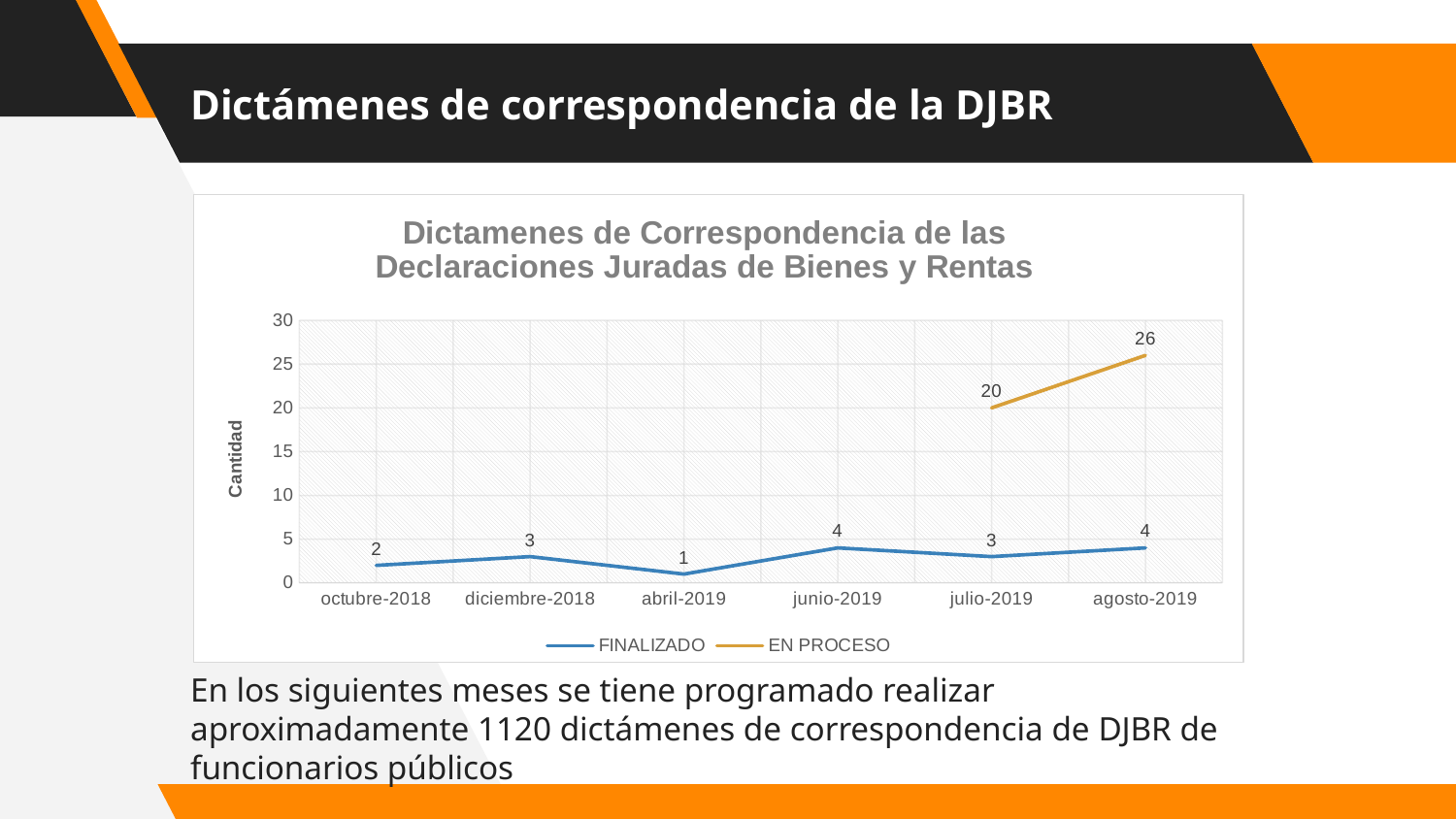
How many series does the legend list? 2 What is the EN PROCESO value for agosto-2019? 26 What is the FINALIZADO value for octubre-2018? 2 What is the label of the y axis? Cantidad Does the EN PROCESO series rise or fall from julio-2019 to agosto-2019? rise What is the FINALIZADO value for abril-2019? 1 What is the EN PROCESO value for julio-2019? 20 What kind of chart is shown? line chart What is the difference between the EN PROCESO values for agosto-2019 and julio-2019? 6 How many months are shown on the x axis? 6 Which is larger in agosto-2019, the FINALIZADO value or the EN PROCESO value? EN PROCESO Which month has the lowest FINALIZADO value? abril-2019